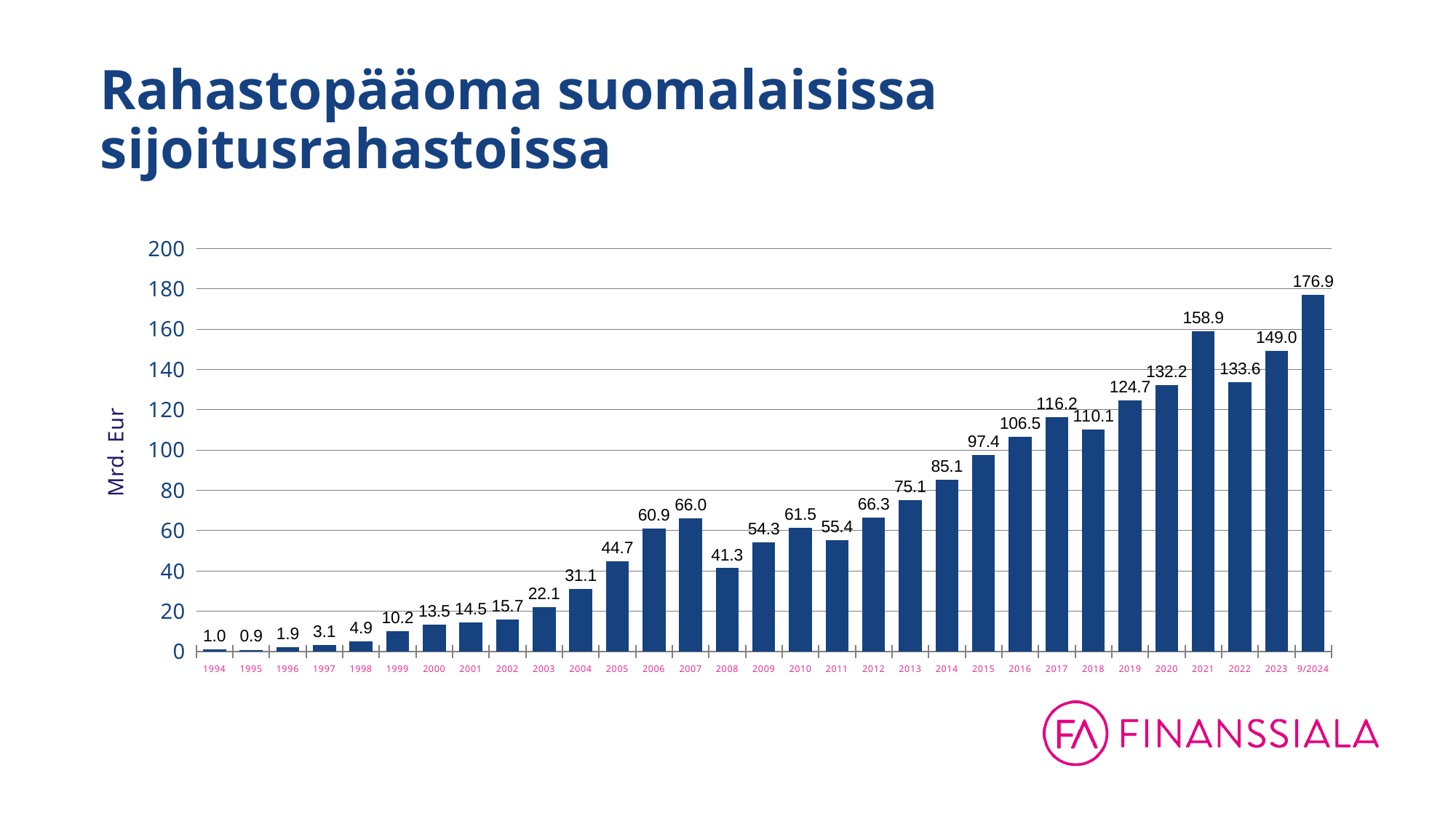
What is the value for 9/2024? 176.9 What is the value for 2021? 158.9 By how much did the value fall from 2007 to 2008? 24.7 What is the value for 2008? 41.3 What is the difference between the values for 2021 and 2022? 25.3 Which year has the lowest value? 1995 Which category has the highest value? 9/2024 What kind of chart is shown on the slide? Bar chart Is the value for 2023 greater or less than 140? greater Which is larger, the value for 2018 or the value for 2017? 2017 What is the label of the vertical axis? Mrd. Eur How many bars are shown in the chart? 31